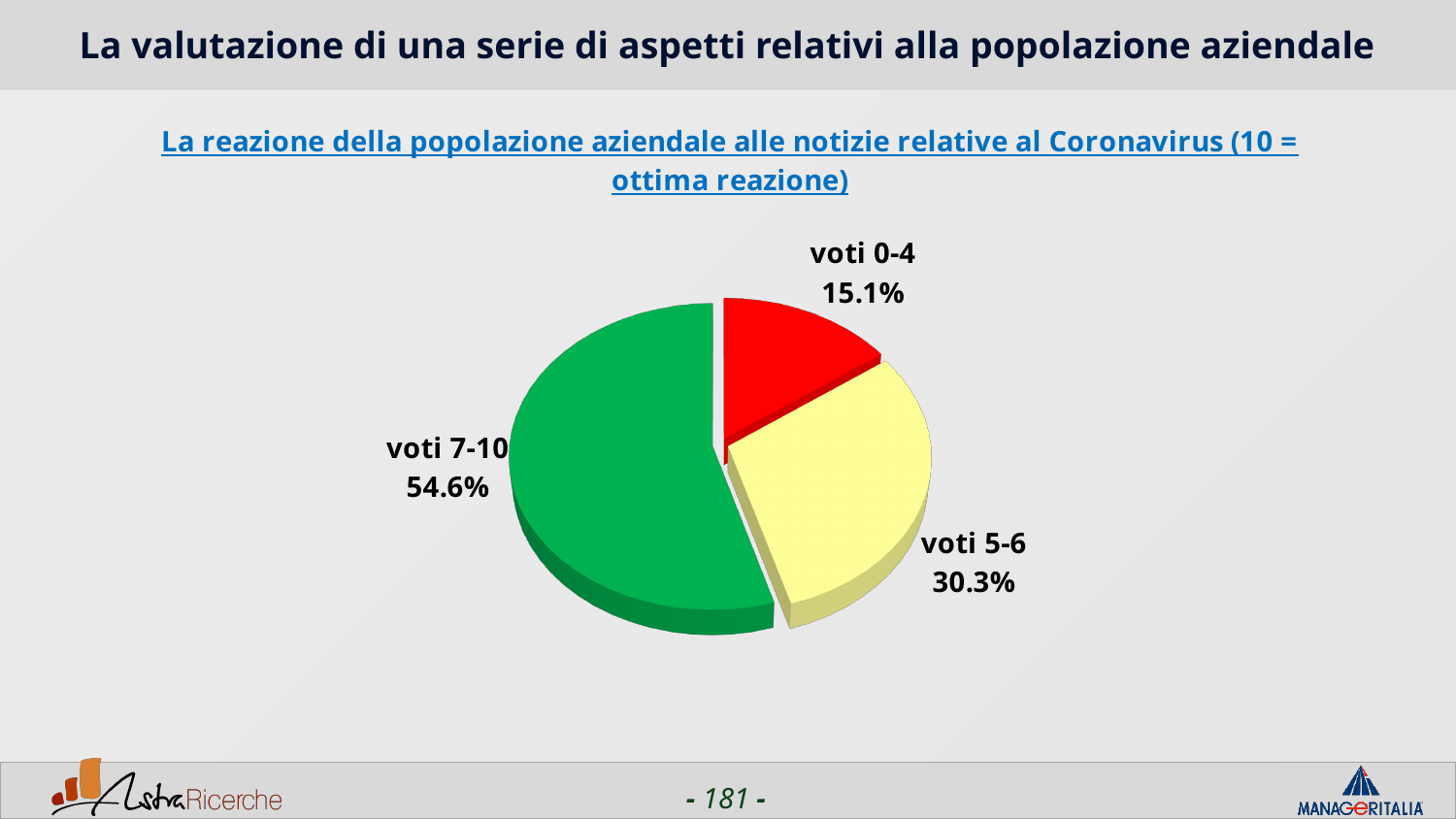
What is the difference in percentage points between 'voti 5-6' and 'voti 0-4'? 15.2 What share of the pie is labelled 'voti 5-6'? 30.3% What kind of chart is shown on the slide? pie chart Which is larger, the share for 'voti 5-6' or the share for 'voti 0-4'? voti 5-6 What is the difference in percentage points between 'voti 7-10' and 'voti 5-6'? 24.3 What share of the pie is labelled 'voti 7-10'? 54.6% What share of the pie is labelled 'voti 0-4'? 15.1% Which slice of the pie is the smallest? voti 0-4 How many slices does the pie chart have? 3 What colour is the 'voti 0-4' slice? red Which slice of the pie is the largest? voti 7-10 What is the title of the chart? La reazione della popolazione aziendale alle notizie relative al Coronavirus (10 = ottima reazione)